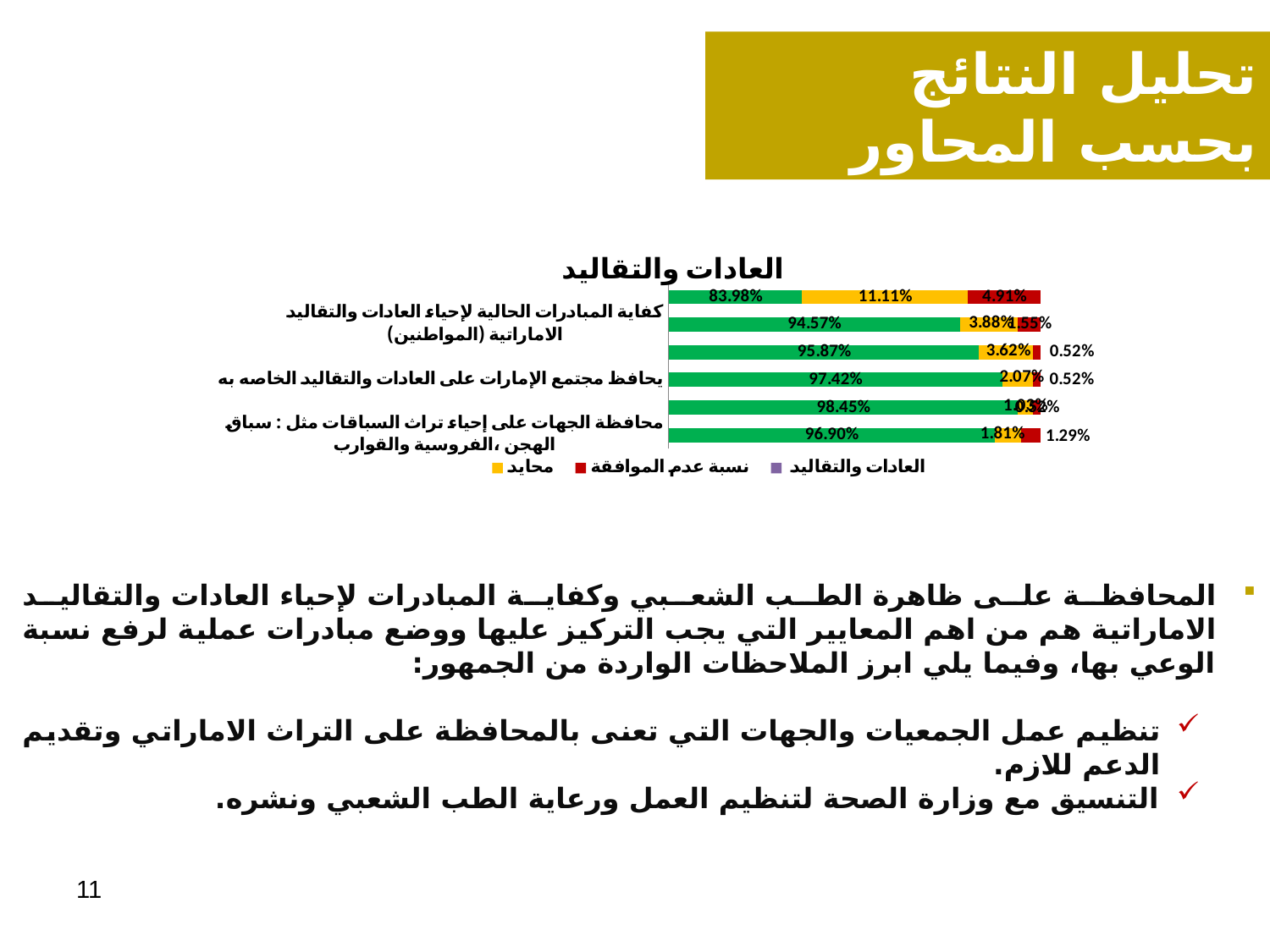
What is the total of the three segments of the top bar? 100.00% What kind of chart is shown on the slide? Stacked horizontal bar chart How many entries does the chart legend list? 3 What is the difference between the yellow (11.11%) and red (4.91%) segments of the top bar? 6.20% How many bars does the chart contain? 6 What is the yellow (محايد) value of the top bar in the chart? 11.11% What is the green (agreement) value of the top bar in the chart? 83.98% What is the red (نسبة عدم الموافقة) value of the top bar in the chart? 4.91% What is the title of the chart? العادات والتقاليد Which bar has the lowest green (agreement) value, and what is it? The top bar, 83.98% In the top bar, which segment is larger: the yellow (محايد) or the red (نسبة عدم الموافقة)? Yellow (محايد), 11.11% Which bar has the highest green (agreement) value, and what is it? The fifth bar from the top, 98.45%